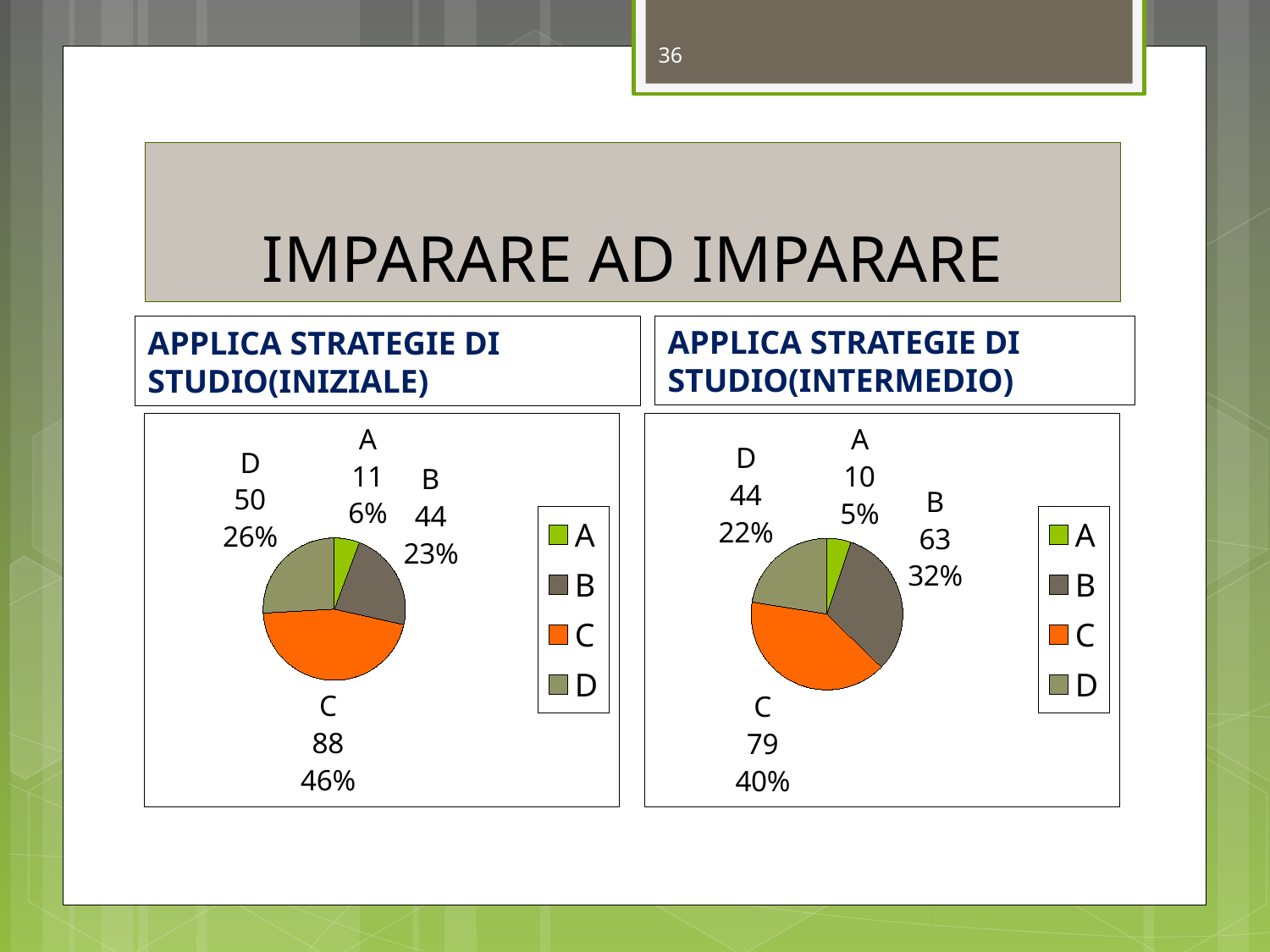
In the APPLICA STRATEGIE DI STUDIO(INTERMEDIO) chart, which is larger, the value for B or the value for D? B In the APPLICA STRATEGIE DI STUDIO(INIZIALE) chart, what is the difference between the values for C and B? 44 In the APPLICA STRATEGIE DI STUDIO(INIZIALE) chart, which category has the largest slice? C In the APPLICA STRATEGIE DI STUDIO(INTERMEDIO) chart, what percentage share does A have? 5% In the APPLICA STRATEGIE DI STUDIO(INTERMEDIO) chart, what is the value for B? 63 What kind of chart is the APPLICA STRATEGIE DI STUDIO(INTERMEDIO) chart? Pie chart How many categories does the APPLICA STRATEGIE DI STUDIO(INIZIALE) chart show? 4 In the APPLICA STRATEGIE DI STUDIO(INIZIALE) chart, what is the value for C? 88 In the APPLICA STRATEGIE DI STUDIO(INIZIALE) chart, what percentage share does D have? 26% In the APPLICA STRATEGIE DI STUDIO(INTERMEDIO) chart, what is the total of the values for A, B, C and D? 196 In the APPLICA STRATEGIE DI STUDIO(INIZIALE) chart, what colour is the slice for C? Orange In the APPLICA STRATEGIE DI STUDIO(INTERMEDIO) chart, which category has the smallest slice? A